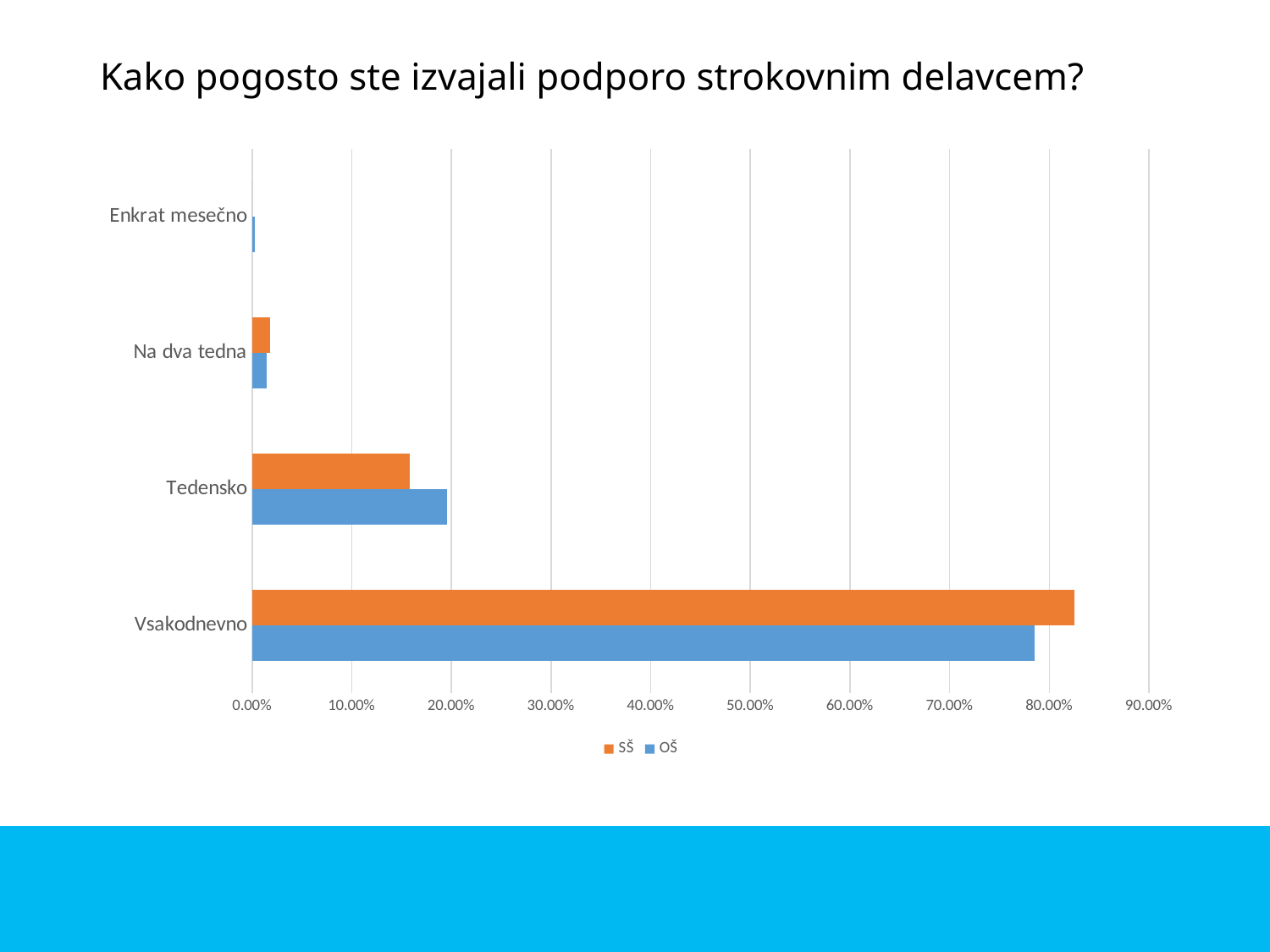
Is the OŠ value for Vsakodnevno greater or less than 80.00%? less What is the title of the chart? Kako pogosto ste izvajali podporo strokovnim delavcem? How many series does the legend list? 2 For Tedensko, which series has the larger value, SŠ or OŠ? OŠ For Vsakodnevno, which series has the larger value, SŠ or OŠ? SŠ Which category has the highest value for the OŠ series? Vsakodnevno Which category has the lowest value for the OŠ series? Enkrat mesečno Is the SŠ value for Vsakodnevno greater or less than 80.00%? greater How many categories are shown on the vertical axis of the chart? 4 Is the OŠ value for Tedensko greater or less than 10.00%? greater Which category has the highest value for the SŠ series? Vsakodnevno What kind of chart is shown on the slide? bar chart